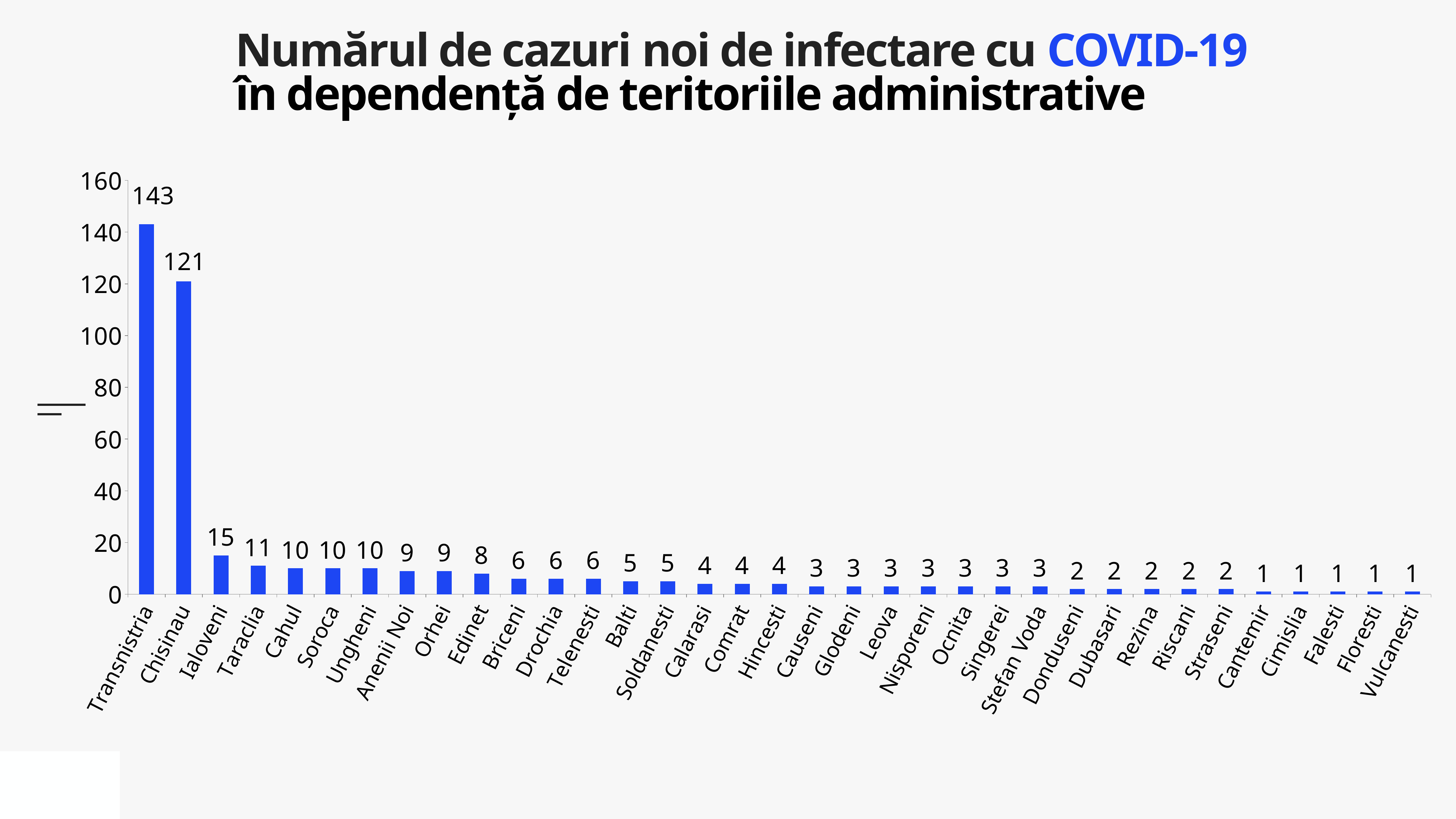
Which territory has the highest number of new COVID-19 cases? Transnistria What is the difference between the values for Transnistria and Chisinau? 22 What is the value for Ialoveni? 15 What is the value for Chisinau? 121 How many territories are shown on the x axis? 35 What is the value for Orhei? 9 Is the value for Chisinau greater or less than 100? greater What is the value for Stefan Voda? 3 Which has a larger value, Edinet or Briceni? Edinet Do the values rise or fall from left to right along the x axis? fall What type of chart is shown on the slide? bar chart What is the difference between the values for Ialoveni and Taraclia? 4